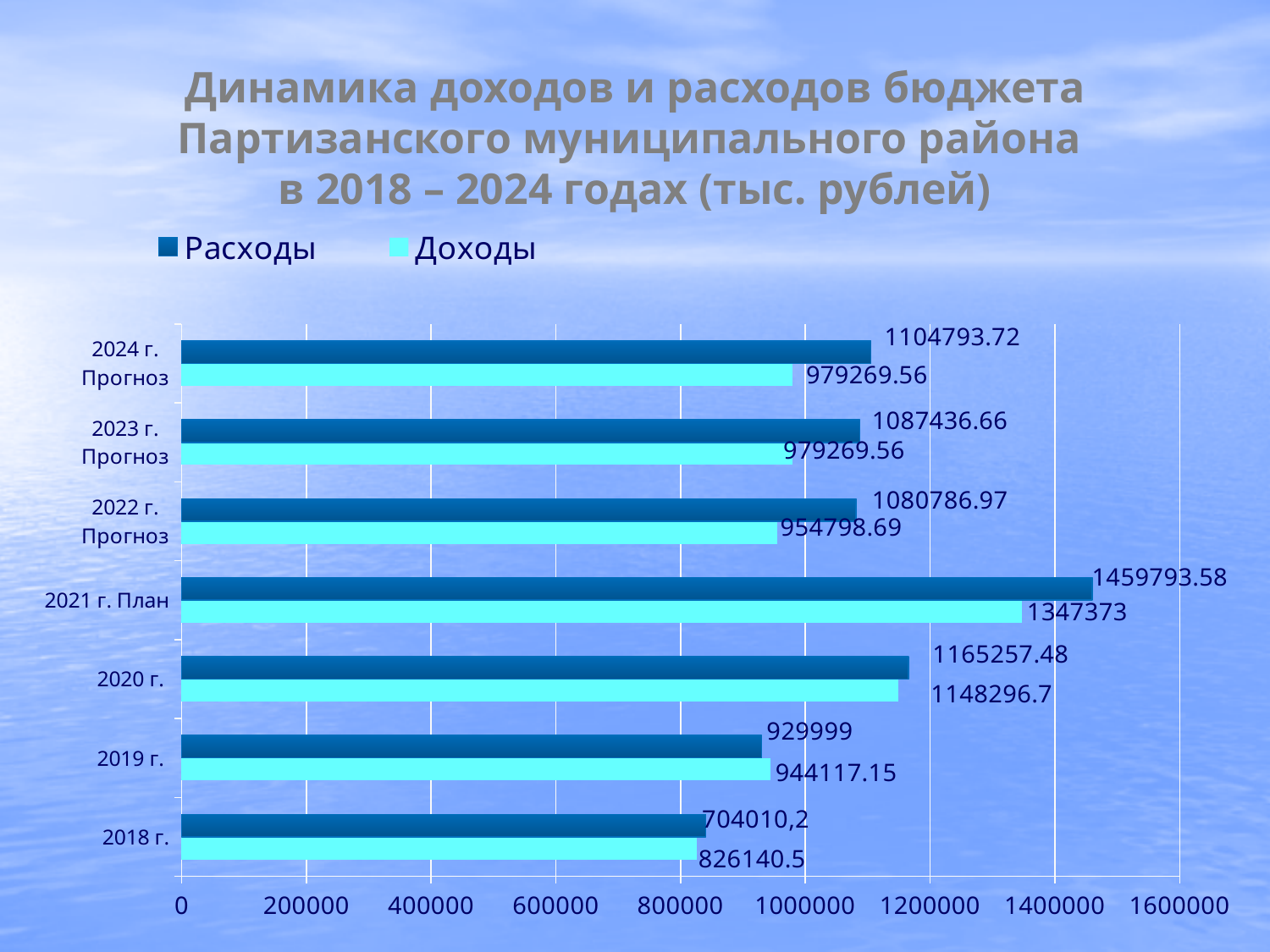
Is the Доходы value for 2022 г. Прогноз greater or less than 1000000? less Which category has the lowest Доходы value? 2018 г. Which category has the highest Расходы value? 2021 г. План How many categories (years) are shown on the chart? 7 What is the value of Доходы for 2023 г. Прогноз? 979269.56 How many series does the legend list? 2 What is the difference between Расходы and Доходы for 2020 г.? 16960.78 What is the difference between Расходы and Доходы for 2021 г. План? 112420.58 What is the value of Доходы for 2020 г.? 1148296.7 For 2019 г., which is larger: Расходы or Доходы? Доходы What is the value of Расходы for 2021 г. План? 1459793.58 What kind of chart is shown on the slide? bar chart